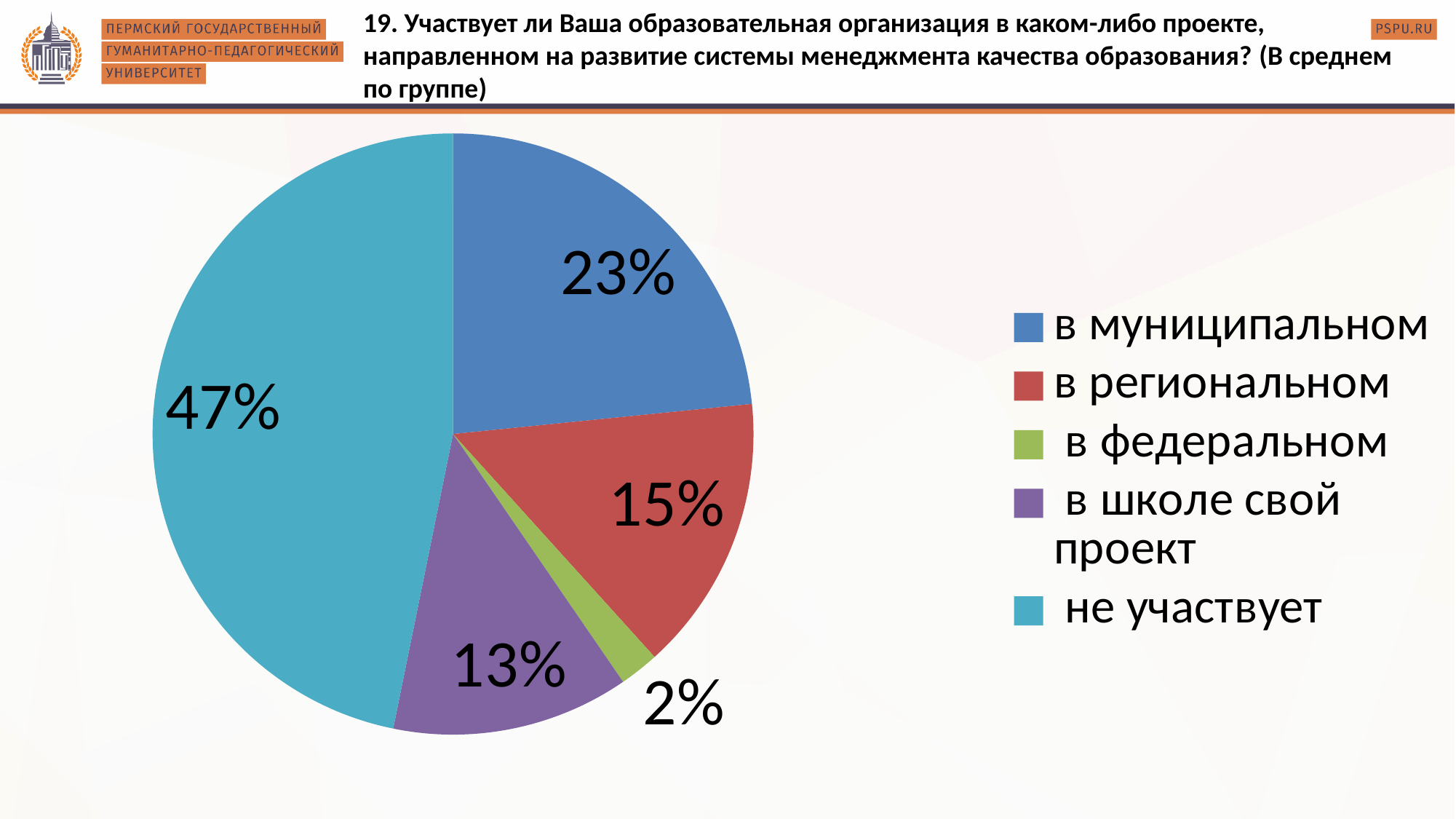
What share of the pie is labelled "в региональном"? 15% What kind of chart is shown on the slide? pie chart What share of the pie is labelled "в школе свой проект"? 13% Which is larger: the slice for "в региональном" or the slice for "в школе свой проект"? в региональном What is the difference in percentage points between "не участвует" and "в муниципальном"? 24 What colour is the slice for "в федеральном"? green What share of the pie is labelled "не участвует"? 47% What share of the pie is labelled "в муниципальном"? 23% How many categories does the pie chart have? 5 Which category has the smallest slice of the pie? в федеральном Which category has the largest slice of the pie? не участвует What share of the pie is labelled "в федеральном"? 2%